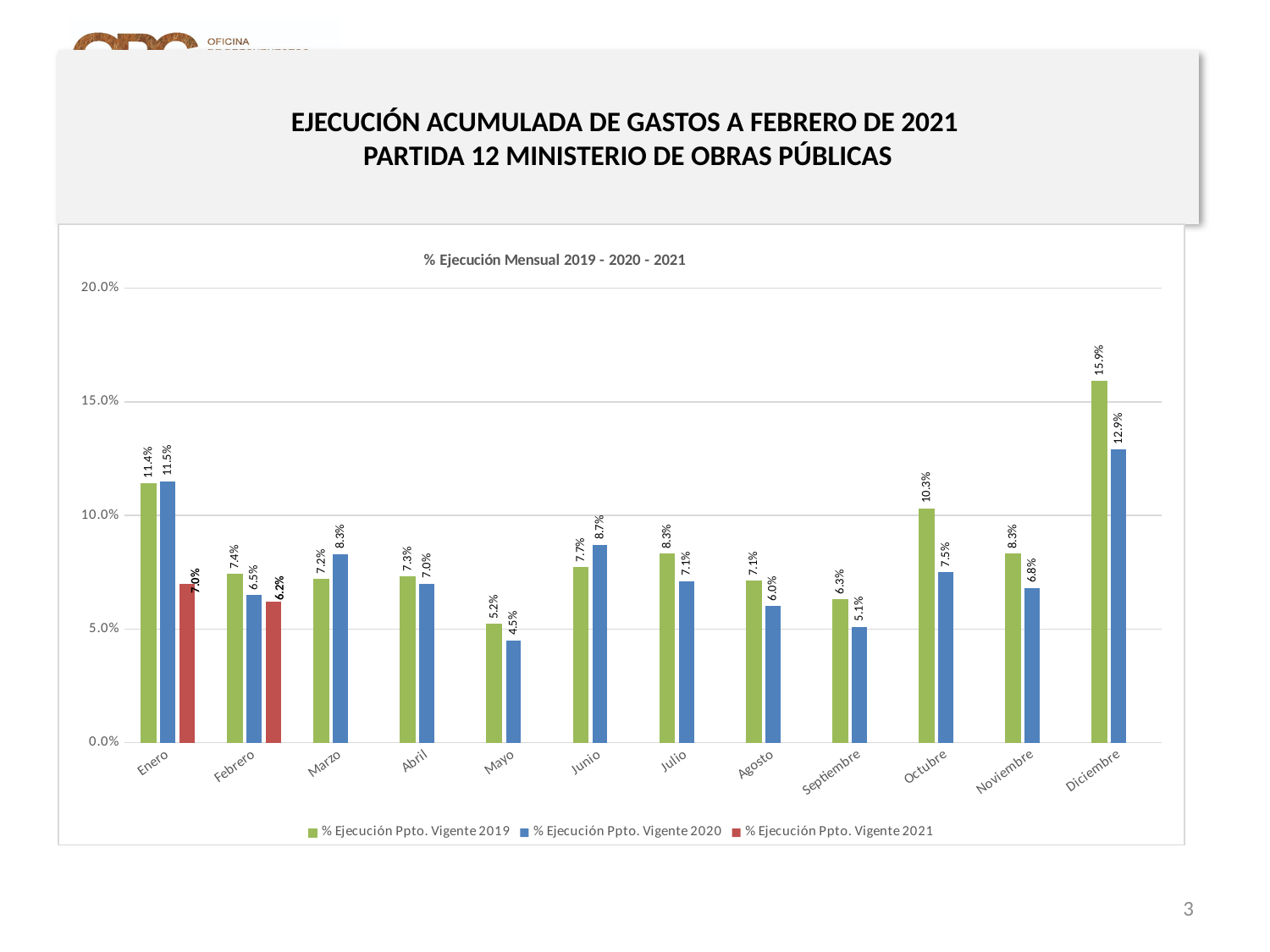
Which month has the lowest value for % Ejecución Ppto. Vigente 2020? Mayo Which month has the highest value for % Ejecución Ppto. Vigente 2019? Diciembre What is the value for % Ejecución Ppto. Vigente 2020 in Junio? 8.7% What is the value for % Ejecución Ppto. Vigente 2021 in Febrero? 6.2% What is the difference between the 2019 and 2020 values in Diciembre? 3.0% What is the title of the chart? % Ejecución Mensual 2019 - 2020 - 2021 What is the value for % Ejecución Ppto. Vigente 2019 in Octubre? 10.3% How many months are shown on the x axis? 12 Is the value for % Ejecución Ppto. Vigente 2019 in Enero greater or less than 10.0%? greater In Marzo, which is larger: the 2019 value or the 2020 value? 2020 How many series does the legend list? 3 What type of chart is shown on the slide? Bar chart